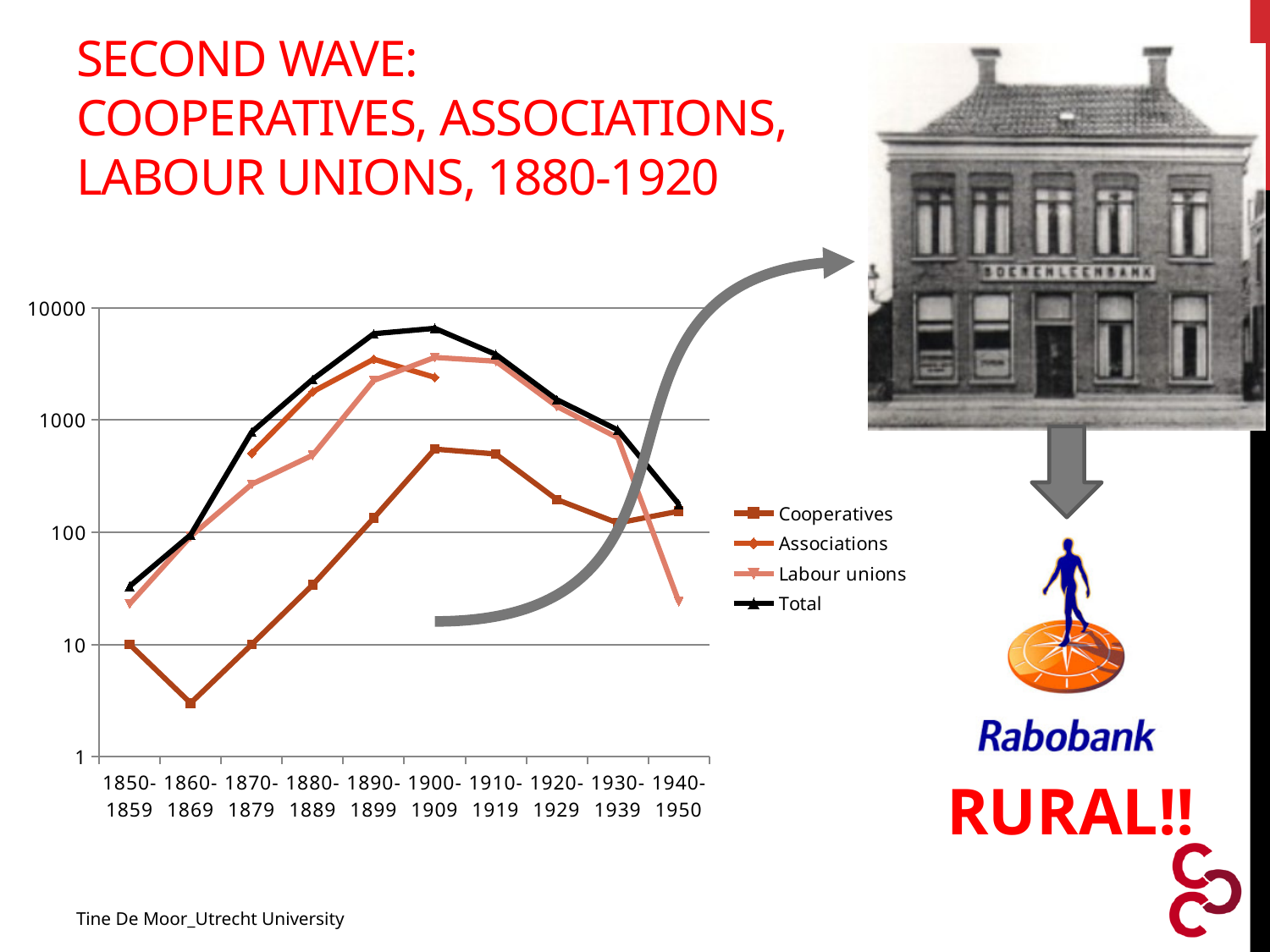
In 1880-1889, which is larger: Associations or Labour unions? Associations In which period does the Total series reach its highest value? 1900-1909 In which period is the Total series at its lowest value? 1850-1859 Is the value for Labour unions in 1940-1950 greater or less than 100? less Is the value for Cooperatives in 1860-1869 greater or less than 10? less What kind of chart is shown on the slide? line chart In which period is the Cooperatives series at its lowest value? 1860-1869 Is the value for Total in 1900-1909 greater or less than 1000? greater Does the Total series rise or fall from 1900-1909 to 1940-1950? fall How many time periods are shown along the x axis of the chart? 10 Which series is drawn in black on the chart? Total How many series does the chart's legend list? 4